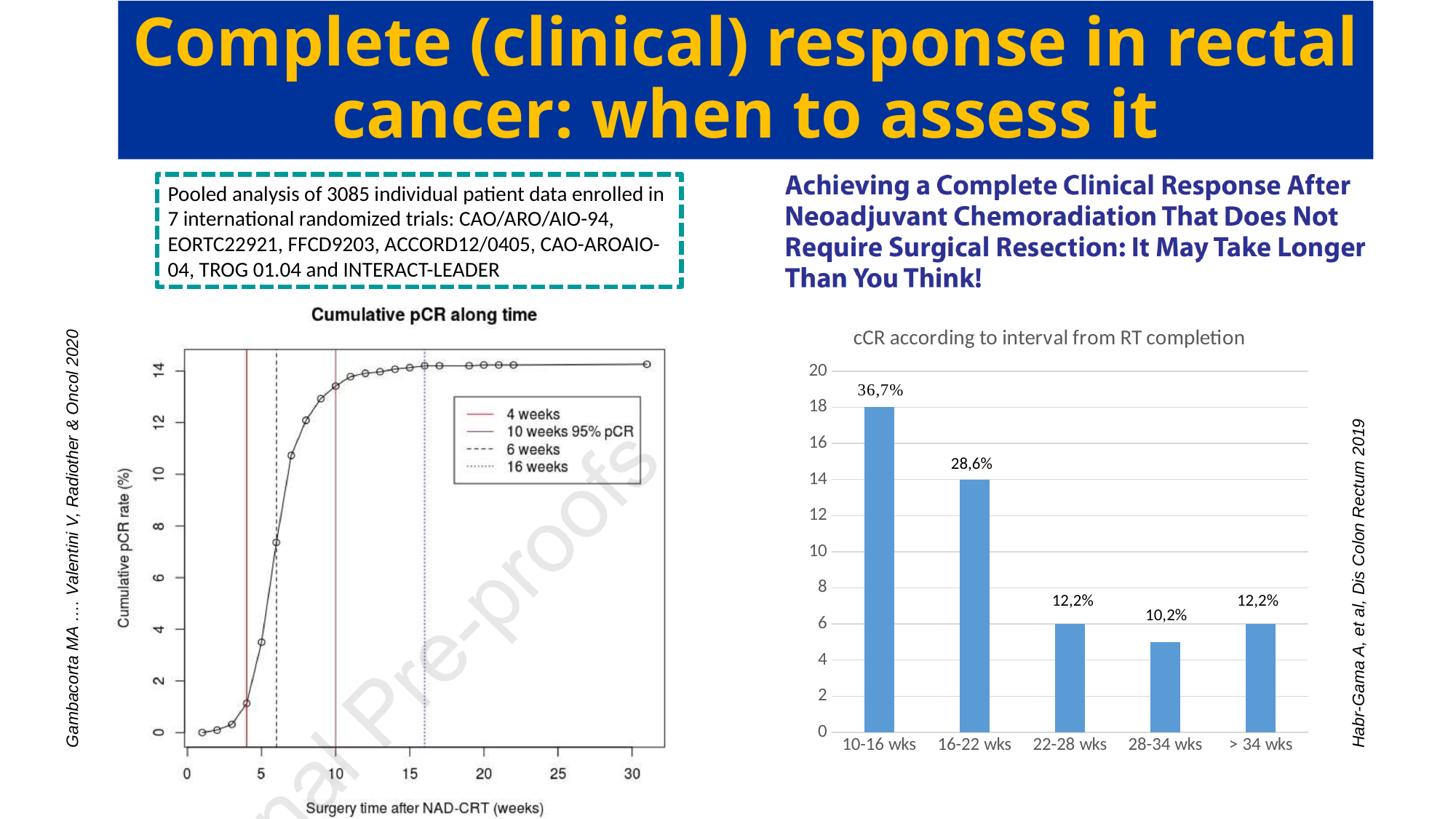
In the chart titled 'cCR according to interval from RT completion', which interval has the highest bar? 10-16 wks In the chart titled 'cCR according to interval from RT completion', what is the data label shown for the 16-22 wks bar? 28,6% What kind of chart is the one titled 'Cumulative pCR along time' on the left of the slide? Line chart In the chart titled 'cCR according to interval from RT completion', is the bar for 16-22 wks greater or less than 10 on the y axis? greater In the chart titled 'cCR according to interval from RT completion', what is the data label shown for the 28-34 wks bar? 10,2% In the chart titled 'Cumulative pCR along time', what is the label of the x axis? Surgery time after NAD-CRT (weeks) What kind of chart is the one titled 'cCR according to interval from RT completion'? Bar chart In the chart titled 'cCR according to interval from RT completion', which bar is taller: 10-16 wks or 16-22 wks? 10-16 wks In the chart titled 'cCR according to interval from RT completion', what is the data label shown for the 10-16 wks bar? 36,7% In the chart titled 'cCR according to interval from RT completion', which interval has the lowest bar? 28-34 wks In the chart titled 'cCR according to interval from RT completion', how many interval categories are shown on the x axis? 5 In the chart titled 'cCR according to interval from RT completion', is the bar for 22-28 wks greater or less than 8 on the y axis? less